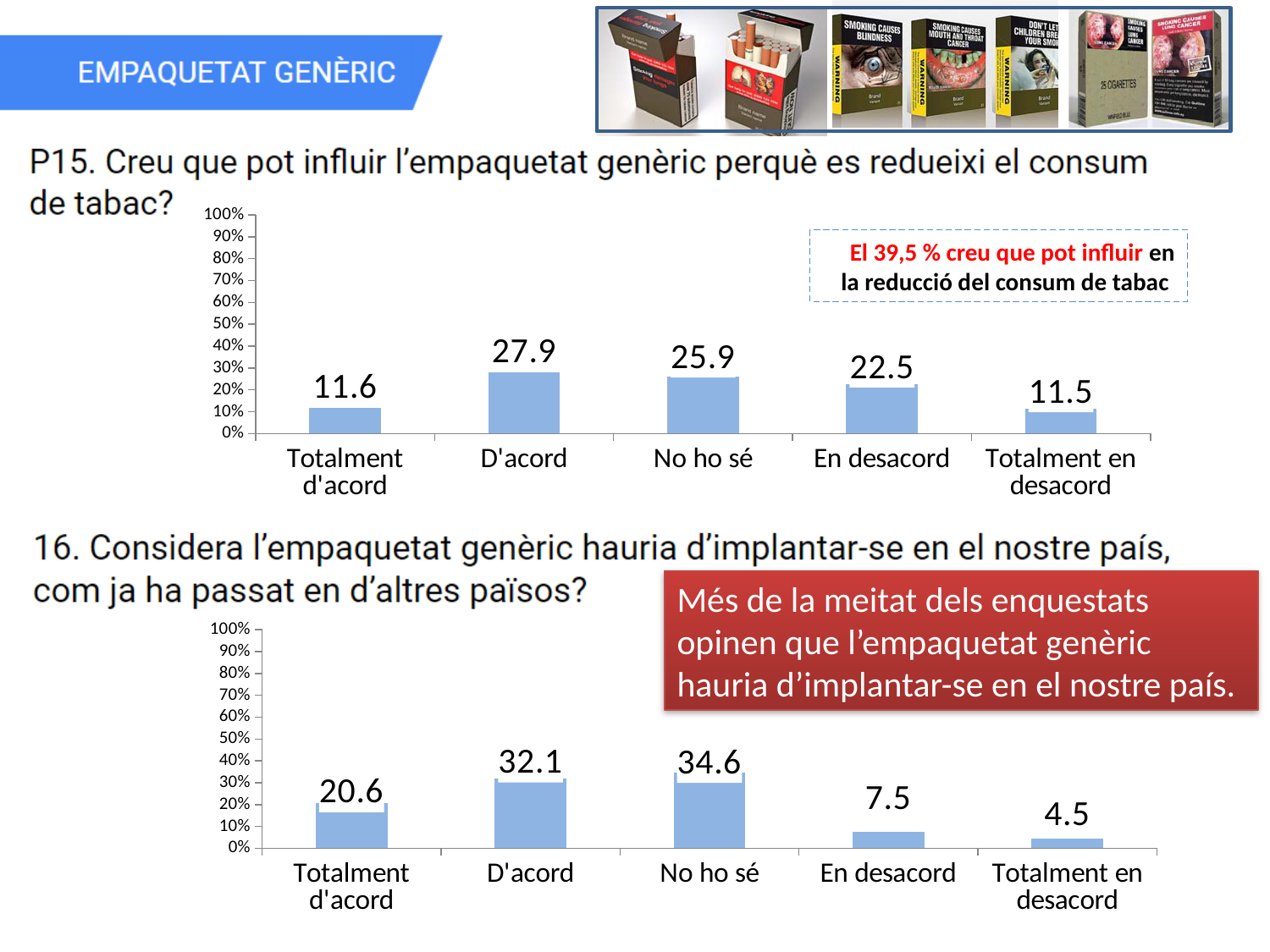
In the P15 chart (top), what is the value for "D'acord"? 27.9 In the question 16 chart (bottom), what is the value for "No ho sé"? 34.6 In the question 16 chart (bottom), which category has the lowest value? Totalment en desacord In the question 16 chart (bottom), what is the difference between "No ho sé" and "D'acord"? 2.5 In the question 16 chart (bottom), which category has the highest value? No ho sé What type of chart is the question 16 chart (bottom)? Bar chart In the P15 chart (top), what is the difference between "D'acord" and "En desacord"? 5.4 In the question 16 chart (bottom), which is larger, "Totalment d'acord" or "En desacord"? Totalment d'acord In the P15 chart (top), which category has the highest value? D'acord In the P15 chart (top), how many categories are shown? 5 In the question 16 chart (bottom), is the value for "En desacord" greater or less than 10%? less In the P15 chart (top), which category has the lowest value? Totalment en desacord